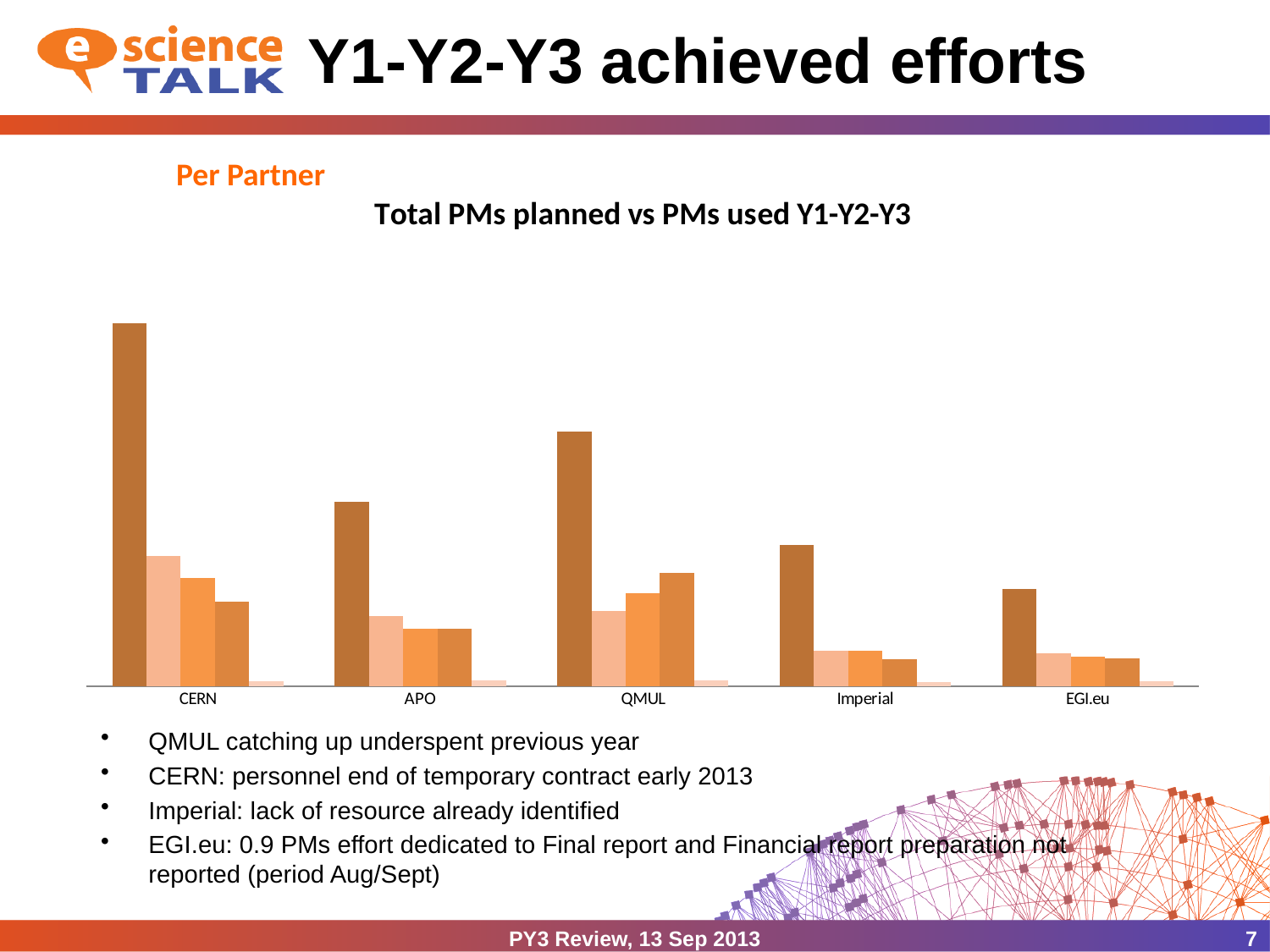
What kind of chart is shown on the slide? Bar chart How many partner categories are shown on the x axis of the chart? 5 Which partners are listed along the x axis of the chart? CERN, APO, QMUL, Imperial, EGI.eu Which partner has the shortest first (dark brown) bar in the chart? EGI.eu Is the first (dark brown) bar for QMUL taller or shorter than the first bar for Imperial? Taller Is the first (dark brown) bar for CERN taller or shorter than the first bar for APO? Taller What is the title of the chart? Total PMs planned vs PMs used Y1-Y2-Y3 Which partner has the second tallest first (dark brown) bar in the chart? QMUL Which partner has the tallest bar in the chart? CERN How many bars are plotted for each partner in the chart? 5 Is the first (dark brown) bar for Imperial taller or shorter than the first bar for EGI.eu? Taller